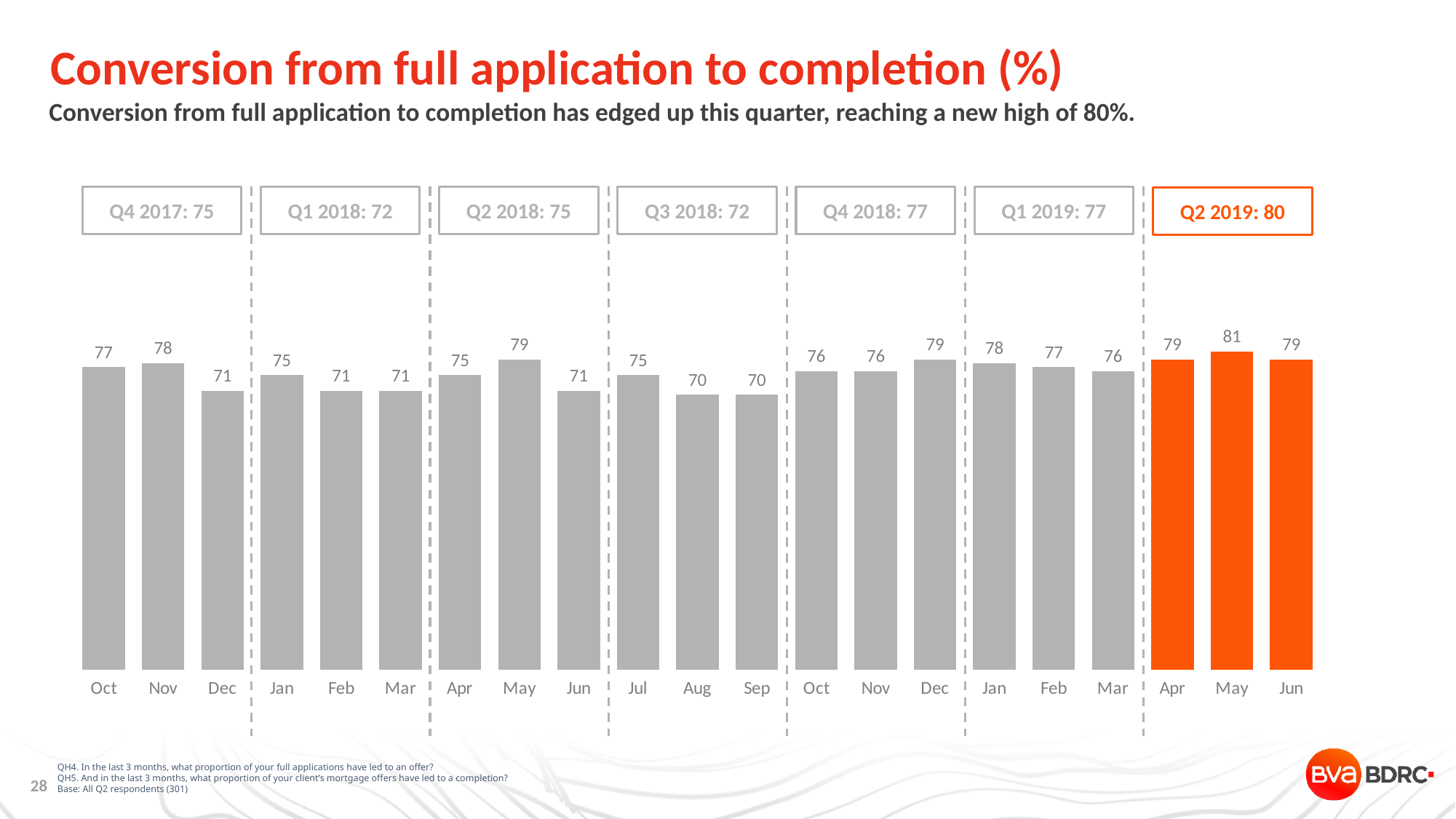
Which quarter's bars are highlighted in orange? Q2 2019 How many monthly bars are plotted on the chart? 21 What is the difference between the values for Nov and Dec in Q4 2017? 7 What kind of chart is shown on the slide? Bar chart What is the quarterly figure shown in the box for Q3 2018? 72 What is the lowest monthly value shown on the chart? 70 Which is larger, the value for Jan in Q1 2019 or the value for Jan in Q1 2018? Jan in Q1 2019 What is the value for Aug in Q3 2018? 70 What is the difference between the values for May and Apr in Q2 2019? 2 Which month has the highest conversion value on the chart? May (Q2 2019) What is the value for May in Q2 2019? 81 What is the value for Dec in Q4 2017? 71